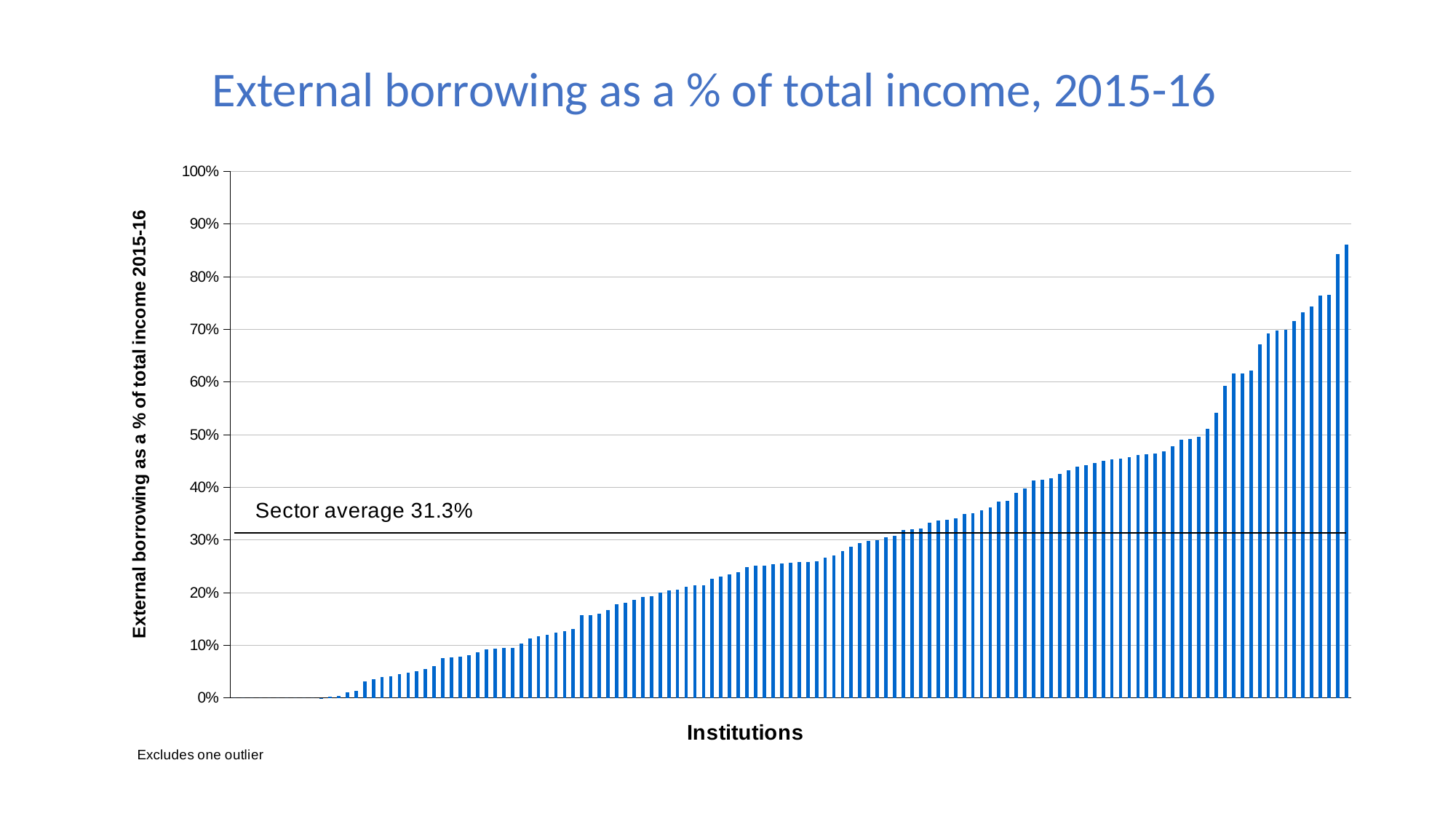
Do the bar values rise or fall from left to right along the x axis? rise What kind of chart is shown on the slide? bar chart What is the label of the x axis? Institutions Is the sector average line above or below the 30% gridline? above What is the title of the chart? External borrowing as a % of total income, 2015-16 What sector average value is marked on the chart? 31.3% Is the value of the leftmost bar greater or less than 10%? less Is the value of the tallest bar greater or less than 80%? greater What is the highest value shown on the y axis? 100% Is the value of the rightmost bar greater or less than the sector average of 31.3%? greater